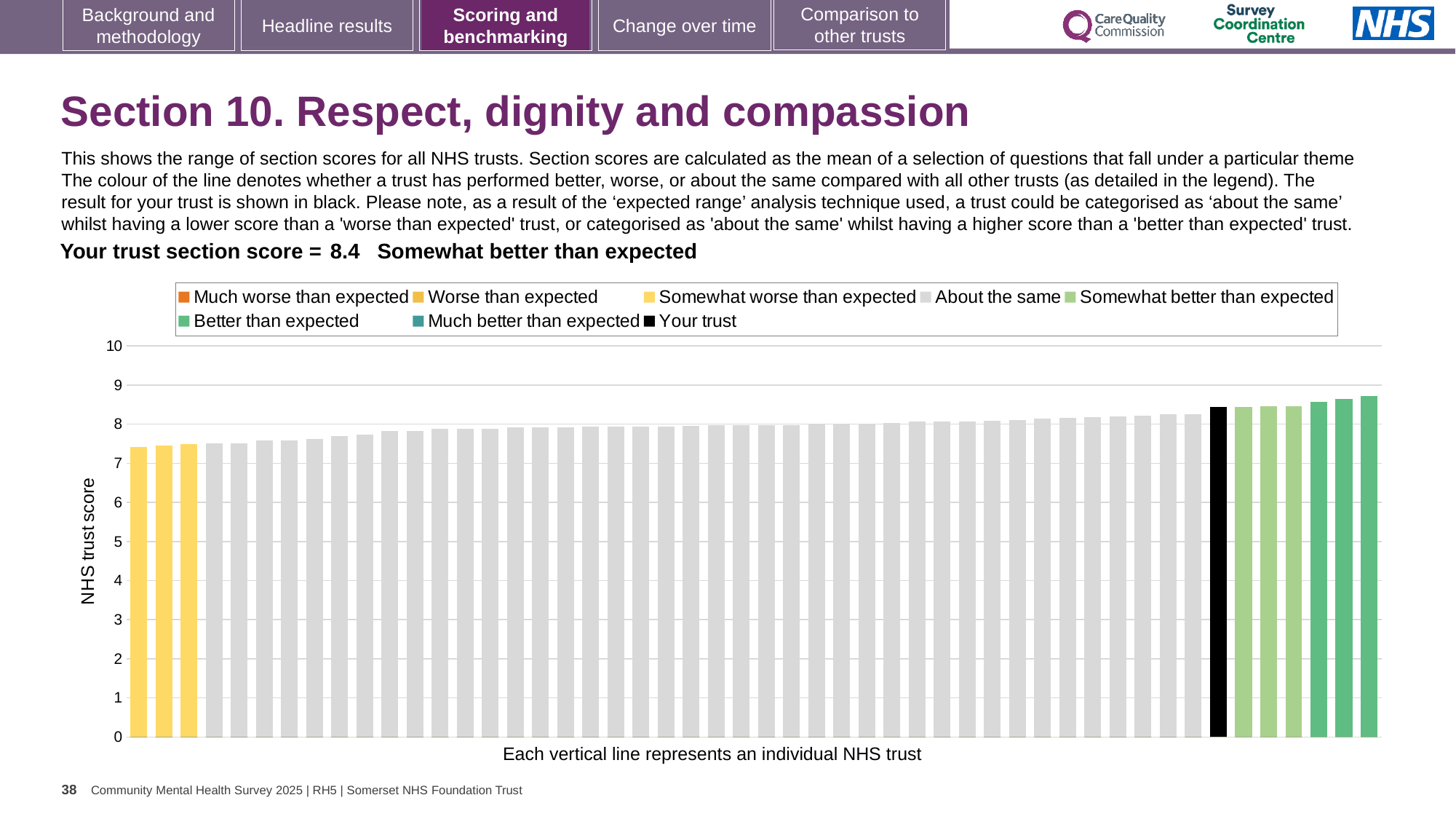
How many bars are coloured yellow (somewhat worse than expected)? 3 Which is larger: the value for your trust (black bar) or the value of the leftmost bar? Your trust What is the section score for your trust shown on the slide? 8.4 How many entries does the chart legend list? 8 Do the bar values rise or fall from left to right along the x axis? Rise Is the value for your trust (the black bar) greater or less than 8? greater What category does the slide say your trust falls into for this section? Somewhat better than expected What kind of chart is shown on the slide? Bar chart Is the value of the leftmost (lowest) bar greater or less than 8? less What is the label on the vertical axis of the chart? NHS trust score Which is larger: the value of the rightmost bar or the value for your trust (black bar)? The rightmost bar Is the value of the rightmost (highest) bar greater or less than 9? less